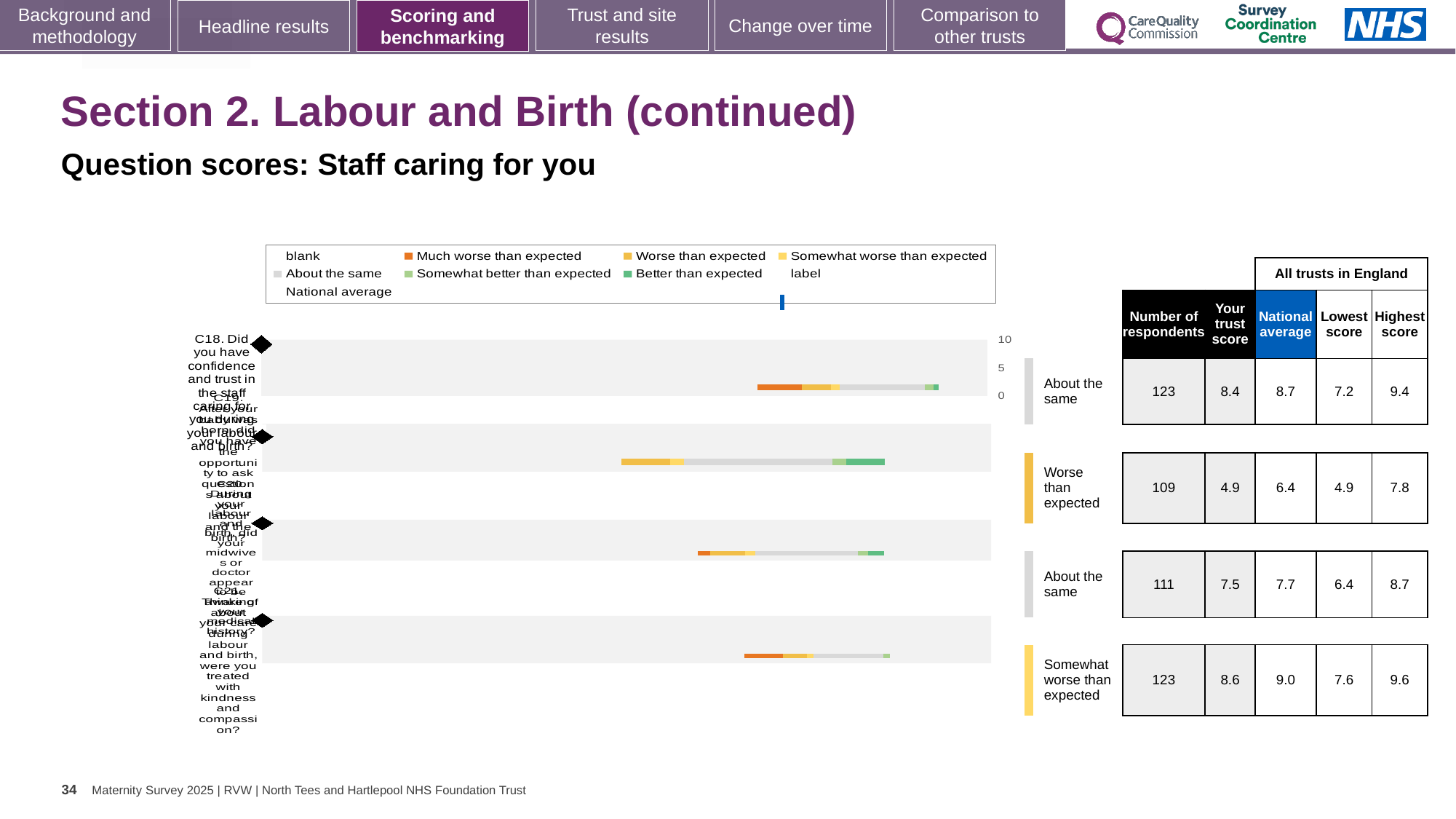
Which row of the table has the highest 'Your trust score'? The fourth row (8.6) In the third row of the table, what is the difference between the highest score and the lowest score? 2.3 What kind of chart is shown on the slide? Bar chart How many questions are plotted in the chart? 4 Which row of the table has the lowest 'Your trust score'? The second row (4.9) In the second row of the table, how much higher is the national average than the trust score? 1.5 What benchmark category is given for the second row of the table? Worse than expected What is the national average for the second row of the table (the row labelled 'Worse than expected')? 6.4 How many respondents are shown for question C18 (the first row of the table)? 123 For question C18 (first row), which is larger: the trust score or the national average? National average What is the 'Your trust score' value for question C18, the first row of the table? 8.4 What is the highest score for the fourth row of the table (the row labelled 'Somewhat worse than expected')? 9.6